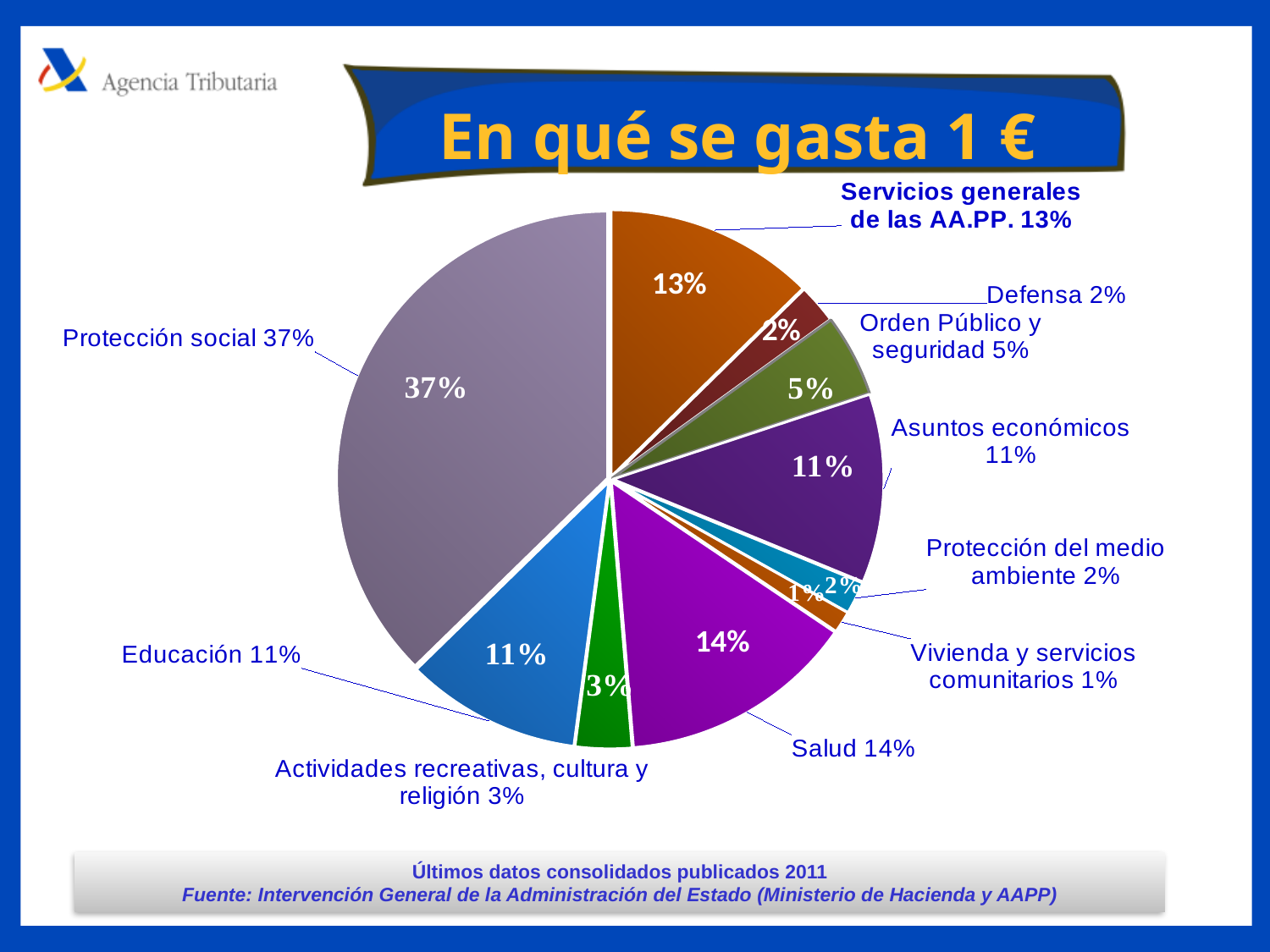
What is the value for Vivienda y servicios comunitarios? 1% Which category has the smallest slice of the pie? Vivienda y servicios comunitarios What is the value for Orden Público y seguridad? 5% How many categories are shown in the pie chart? 10 Which category has the largest slice of the pie? Protección social What is the value for Salud? 14% What is the difference between the values for Educación and Actividades recreativas, cultura y religión? 8% What is the title of the chart? En qué se gasta 1 € What kind of chart is shown on the slide? Pie chart What is the difference between the values for Protección social and Salud? 23% What share of the pie does Protección social represent? 37% Which is larger, Servicios generales de las AA.PP. or Asuntos económicos? Servicios generales de las AA.PP.